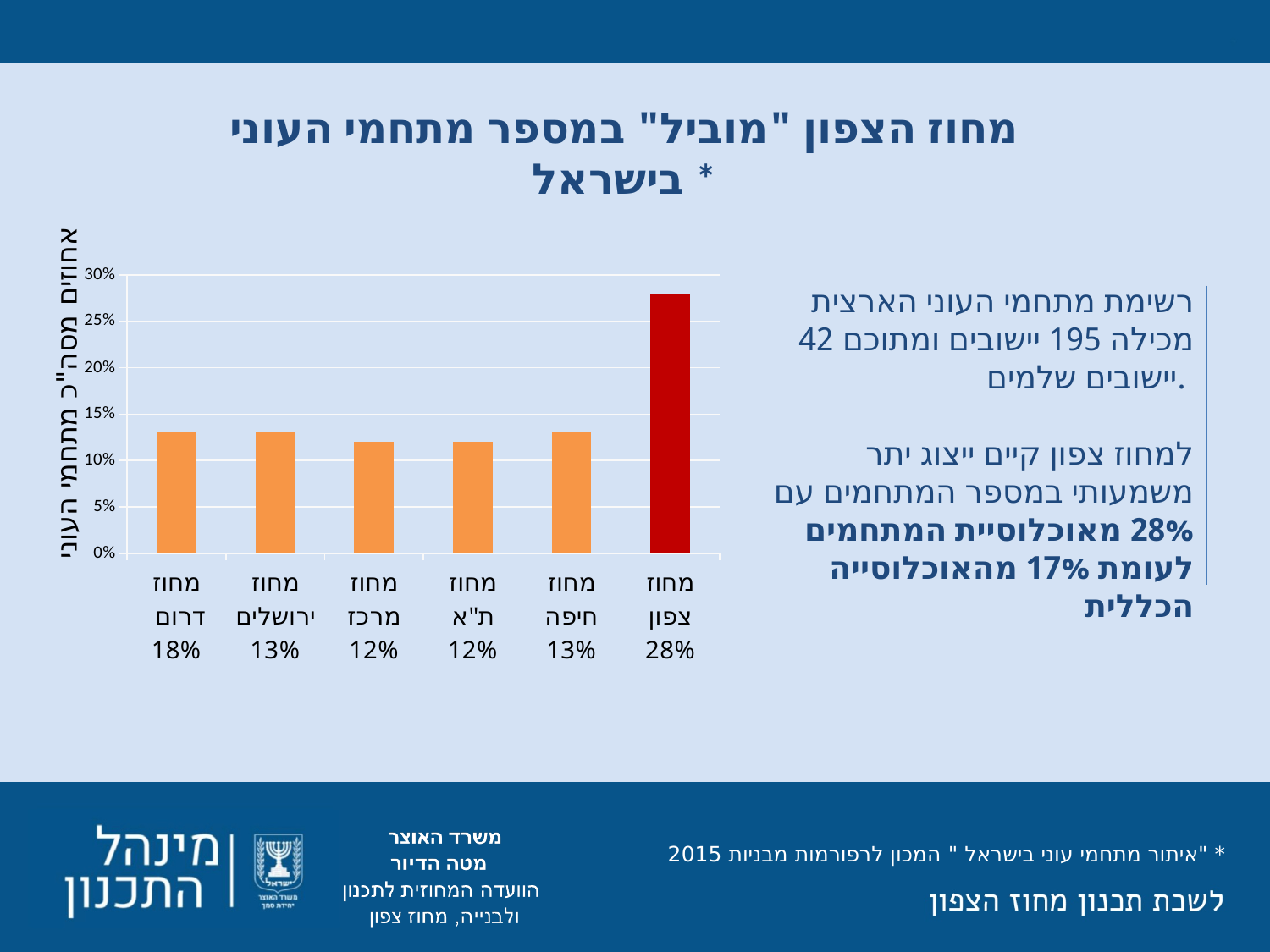
What is the value shown for מחוז ת"א? 12% Which district has the highest value in the chart? מחוז צפון What type of chart is shown on the slide? bar chart What is the value shown for מחוז מרכז? 12% What is the value shown for מחוז צפון? 28% What is the difference between the values for מחוז צפון and מחוז חיפה? 15% Which district's bar is coloured red instead of orange? מחוז צפון What is the value shown for מחוז ירושלים? 13% How many districts (categories) are shown on the x axis of the chart? 6 Which is larger, the value for מחוז צפון or the value for מחוז ירושלים? מחוז צפון What is the value shown for מחוז חיפה? 13% Is the value for מחוז צפון greater or less than 25%? greater